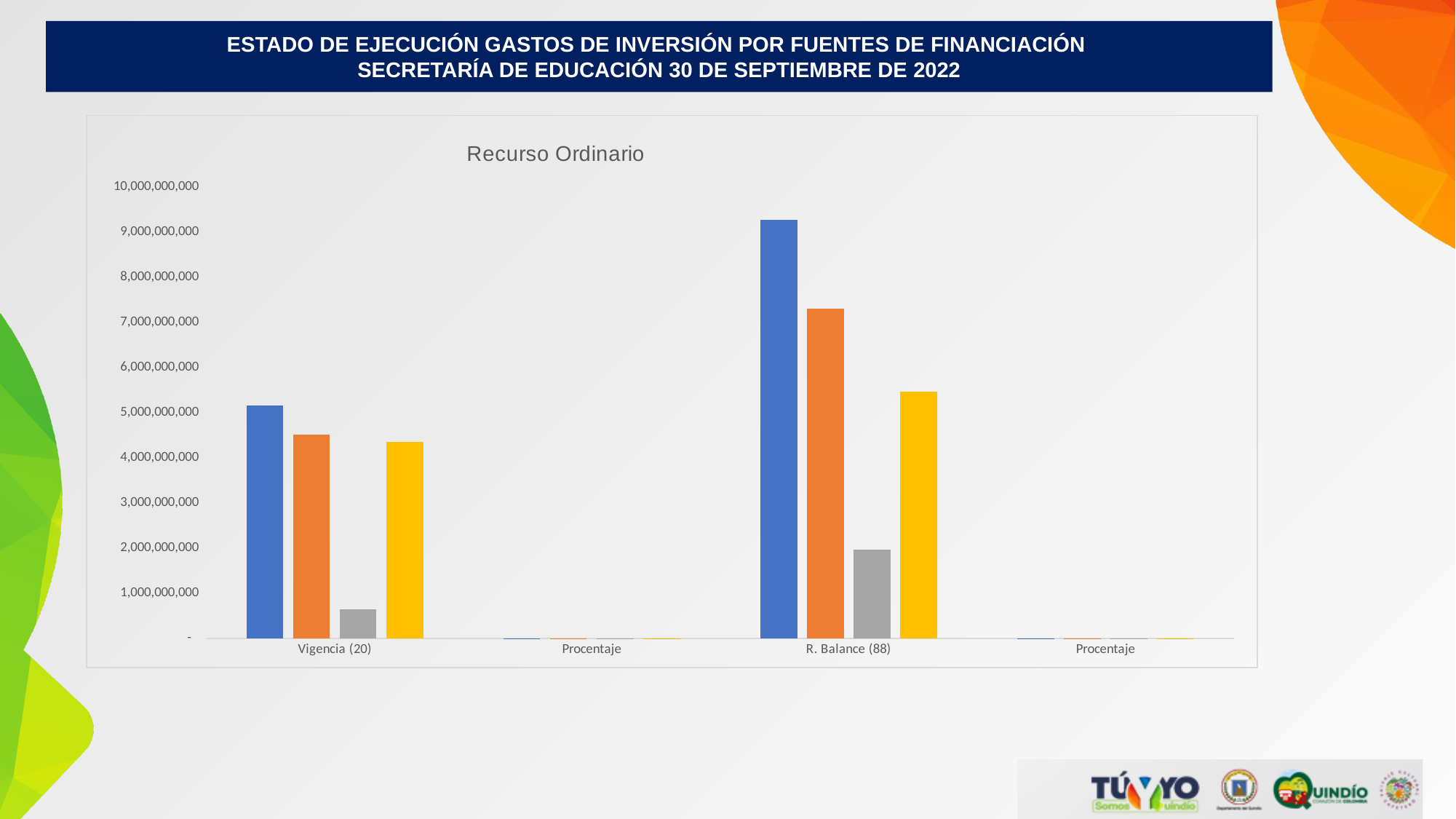
Which category has the tallest bar in the chart? R. Balance (88) Is the value of the orange bar for Vigencia (20) greater or less than 4,000,000,000? greater Is the value of the gray bar for Vigencia (20) greater or less than 1,000,000,000? less Which colour bar is the shortest within the Vigencia (20) category? gray Is the value of the blue bar for R. Balance (88) greater or less than 8,000,000,000? greater Which is larger, the blue bar for Vigencia (20) or the blue bar for R. Balance (88)? R. Balance (88) What kind of chart is shown on the slide? bar chart What is the title of the chart? Recurso Ordinario How many categories are shown on the x axis of the chart? 4 Which is larger, the orange bar for Vigencia (20) or the orange bar for R. Balance (88)? R. Balance (88)